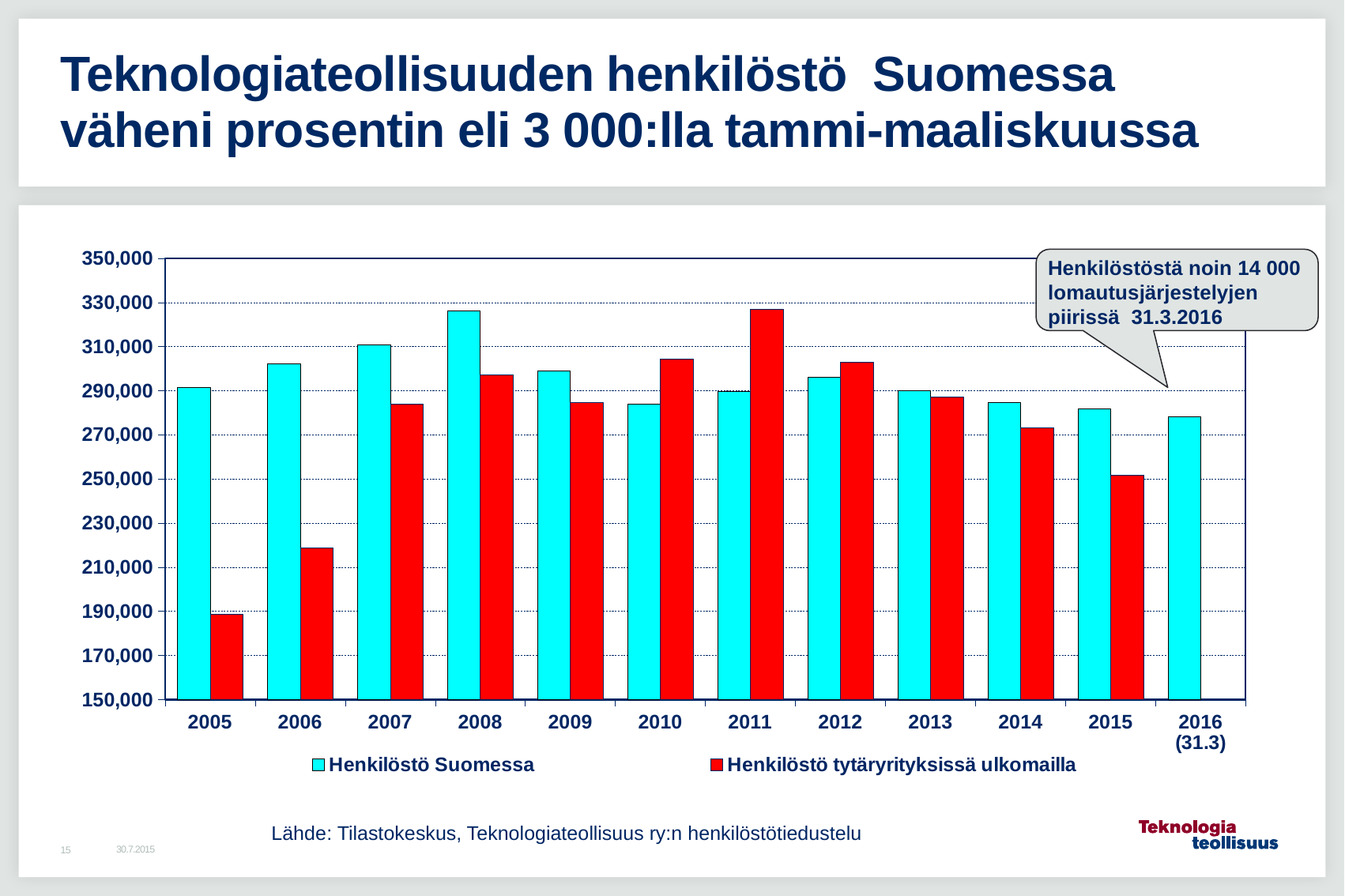
Is the value for Henkilöstö tytäryrityksissä ulkomailla in 2015 greater or less than 270,000? less Is the value for Henkilöstö tytäryrityksissä ulkomailla in 2005 greater or less than 210,000? less How many series does the legend list? 2 Is the value for Henkilöstö Suomessa in 2008 greater or less than 310,000? greater How many years (categories) are shown on the x axis? 12 In which year is the value for Henkilöstö tytäryrityksissä ulkomailla highest? 2011 What kind of chart is shown on the slide? Bar chart Does the value for Henkilöstö Suomessa rise or fall from 2008 to 2016 (31.3)? Fall In 2011, which series has the larger value: Henkilöstö Suomessa or Henkilöstö tytäryrityksissä ulkomailla? Henkilöstö tytäryrityksissä ulkomailla In which year is the value for Henkilöstö tytäryrityksissä ulkomailla lowest? 2005 What are the two legend entries of the chart? Henkilöstö Suomessa; Henkilöstö tytäryrityksissä ulkomailla In which year is the value for Henkilöstö Suomessa highest? 2008